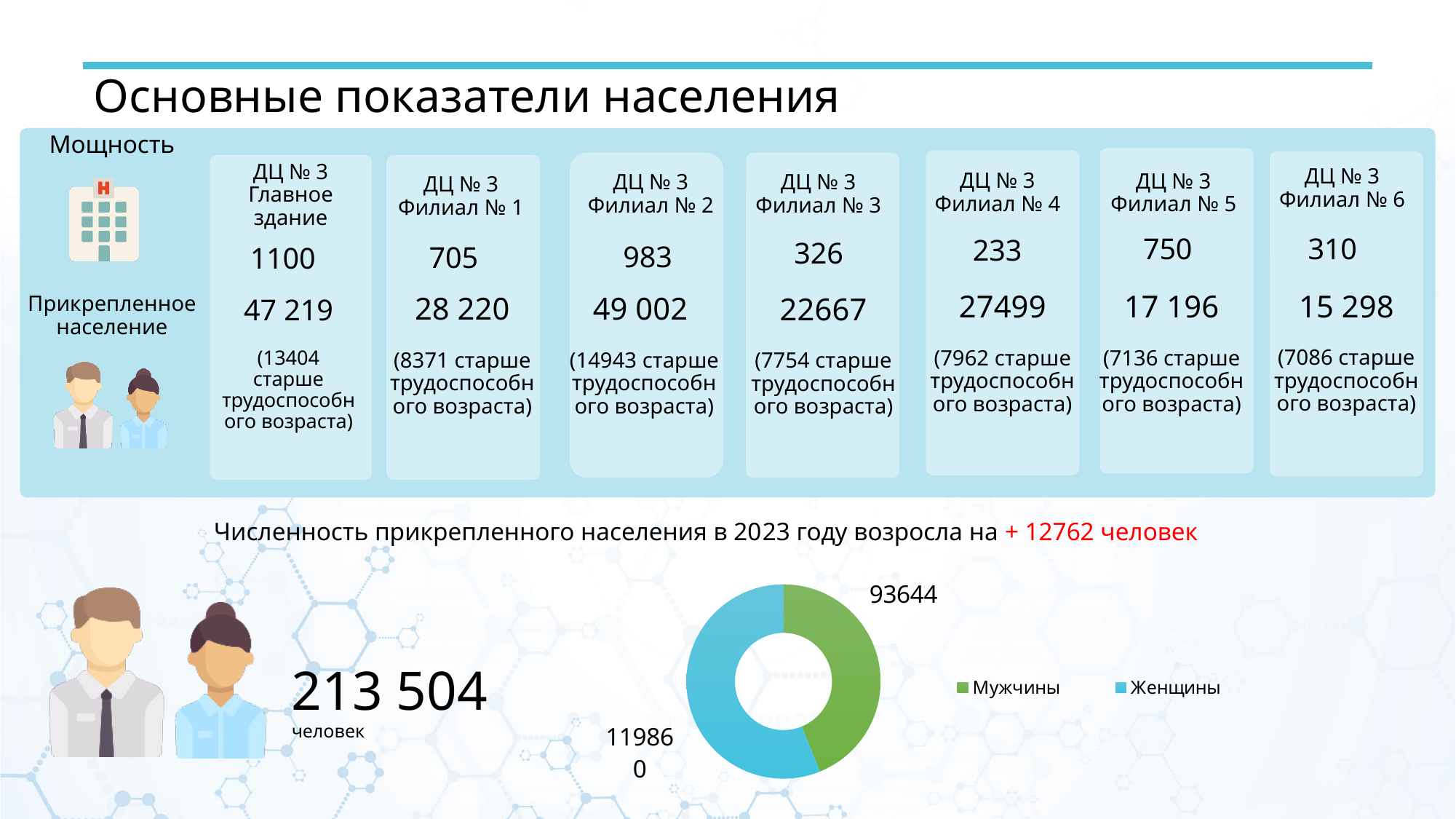
What colour represents Женщины in the donut chart? Blue Which category in the donut chart has the larger value? Женщины Which category in the donut chart has the smaller value? Мужчины Is the value for Женщины larger or smaller than the value for Мужчины in the donut chart? Larger In the donut chart, what is the value for Мужчины? 93644 What is the total of the two values shown in the donut chart? 213504 What is the difference between the values for Женщины and Мужчины in the donut chart? 26216 How many entries does the legend of the donut chart list? 2 In the donut chart, what is the value for Женщины? 119860 What colour represents Мужчины in the donut chart? Green How many categories does the donut chart show? 2 What kind of chart is shown at the bottom of the slide? Pie (donut) chart